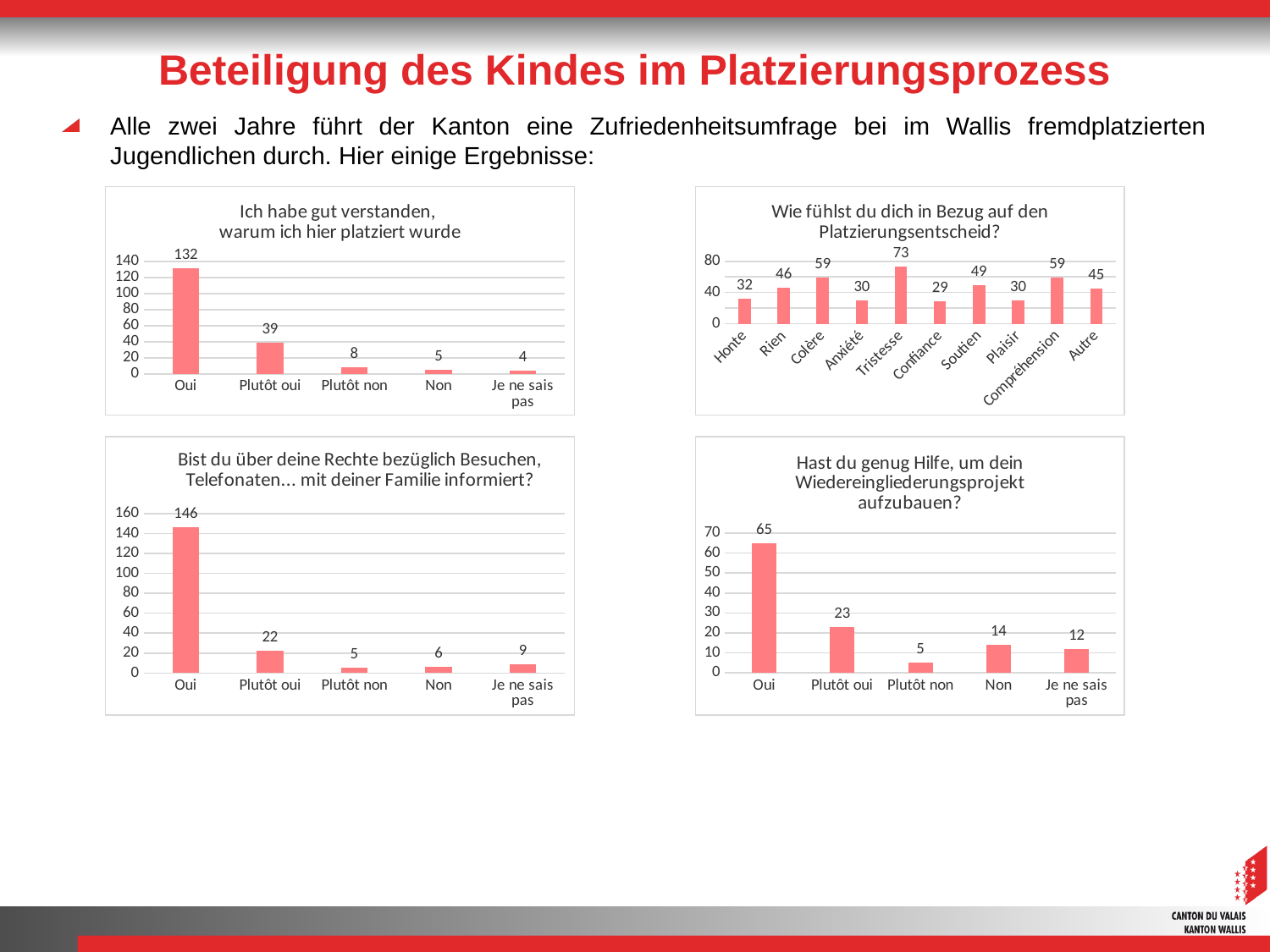
In the top-left chart 'Ich habe gut verstanden, warum ich hier platziert wurde', which category has the lowest value? Je ne sais pas In the bottom-left chart 'Bist du über deine Rechte bezüglich Besuchen, Telefonaten... mit deiner Familie informiert?', what is the value for 'Oui'? 146 What type of chart is the bottom-right chart 'Hast du genug Hilfe, um dein Wiedereingliederungsprojekt aufzubauen?'? Bar chart In the top-right chart 'Wie fühlst du dich in Bezug auf den Platzierungsentscheid?', which is larger, 'Rien' or 'Honte'? Rien In the top-right chart 'Wie fühlst du dich in Bezug auf den Platzierungsentscheid?', what is the value for 'Soutien'? 49 In the top-left chart 'Ich habe gut verstanden, warum ich hier platziert wurde', what is the value for 'Oui'? 132 In the bottom-left chart 'Bist du über deine Rechte bezüglich Besuchen, Telefonaten... mit deiner Familie informiert?', what is the value for 'Je ne sais pas'? 9 In the bottom-right chart 'Hast du genug Hilfe, um dein Wiedereingliederungsprojekt aufzubauen?', what is the difference between 'Non' and 'Je ne sais pas'? 2 How many categories are shown in the top-right chart 'Wie fühlst du dich in Bezug auf den Platzierungsentscheid?'? 10 In the bottom-right chart 'Hast du genug Hilfe, um dein Wiedereingliederungsprojekt aufzubauen?', which category has the lowest value? Plutôt non In the top-right chart 'Wie fühlst du dich in Bezug auf den Platzierungsentscheid?', which category has the highest value? Tristesse In the top-left chart 'Ich habe gut verstanden, warum ich hier platziert wurde', what is the difference between 'Oui' and 'Plutôt oui'? 93